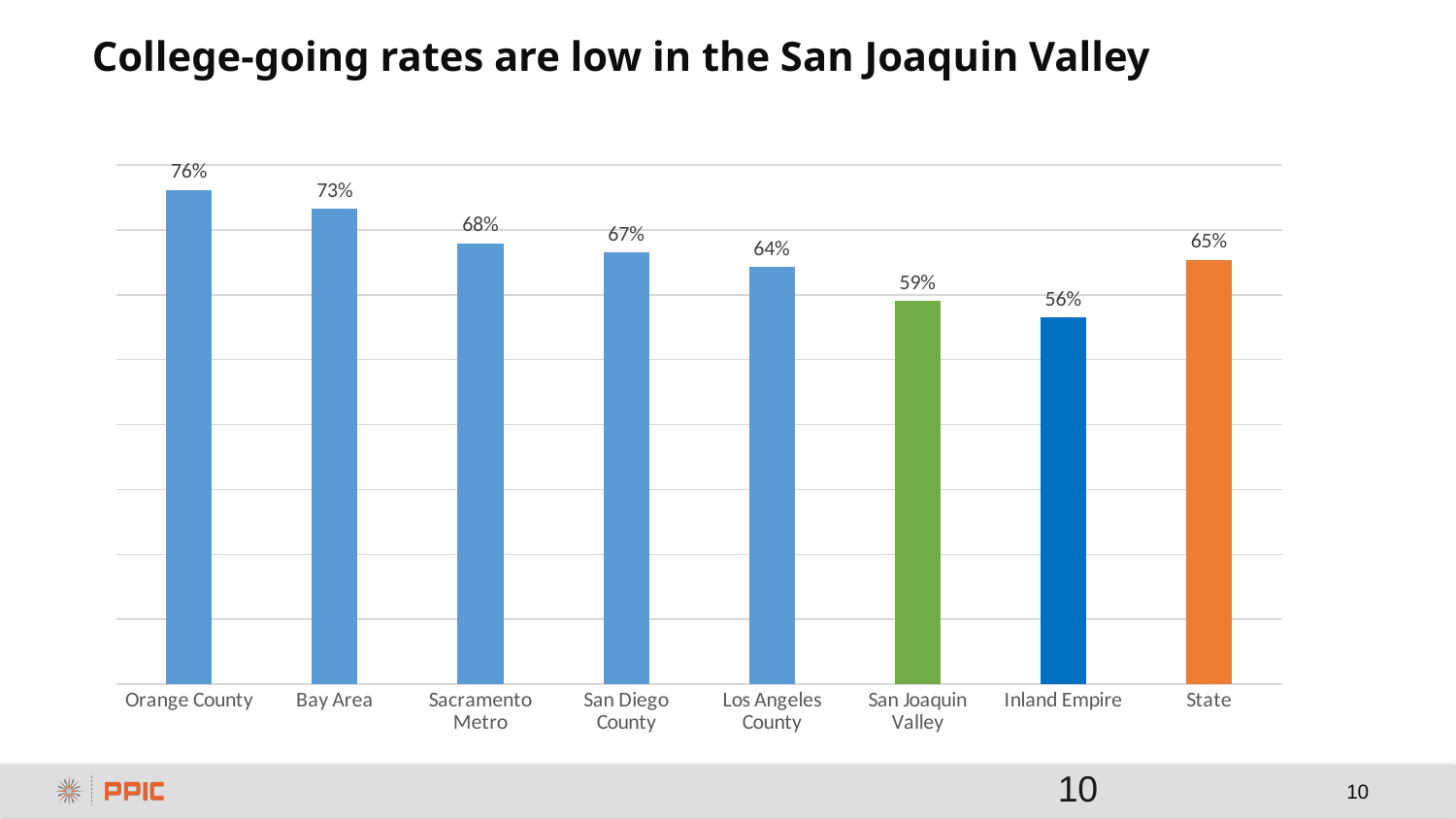
What is the difference between the State rate and the Inland Empire rate? 9 percentage points What kind of chart is shown on the slide? Bar chart What is the college-going rate for the San Joaquin Valley? 59% Which is larger, the rate for Sacramento Metro or the rate for Los Angeles County? Sacramento Metro What is the value shown for the State? 65% Which region has the lowest college-going rate? Inland Empire What is the college-going rate for Orange County? 76% Which is larger, the rate for San Joaquin Valley or the State rate? State What is the difference between the Bay Area rate and the San Joaquin Valley rate? 14 percentage points What is the title of the slide? College-going rates are low in the San Joaquin Valley Which region has the highest college-going rate? Orange County How many regions are shown on the chart? 8